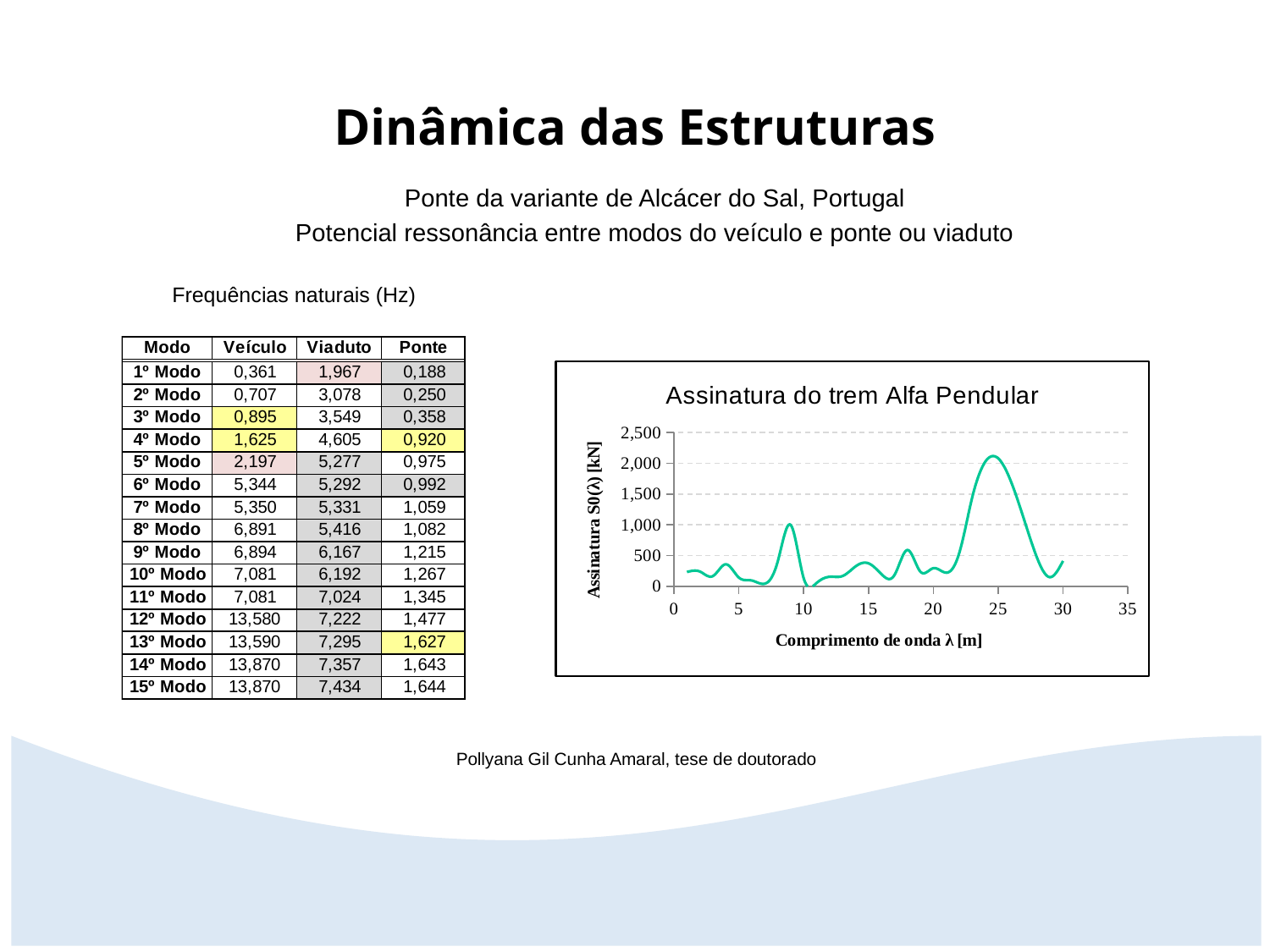
Between wavelengths of 20 m and 25 m, does the curve rise or fall? rise Is the highest peak of the curve greater or less than 2,000 kN? greater What kind of chart is shown on the slide? line chart How many lines are plotted on the chart? 1 Is the highest peak of the curve located between 5 and 15 m or between 20 and 30 m? between 20 and 30 m What is the title of the chart? Assinatura do trem Alfa Pendular Is the value of the curve at a wavelength of 30 m greater or less than 500 kN? less What is the label of the x axis of the chart? Comprimento de onda λ [m] Which peak is higher: the one near 9 m or the one near 25 m? the one near 25 m Is the value of the curve at a wavelength of 15 m greater or less than 500 kN? less Between wavelengths of 25 m and 29 m, does the curve rise or fall? fall